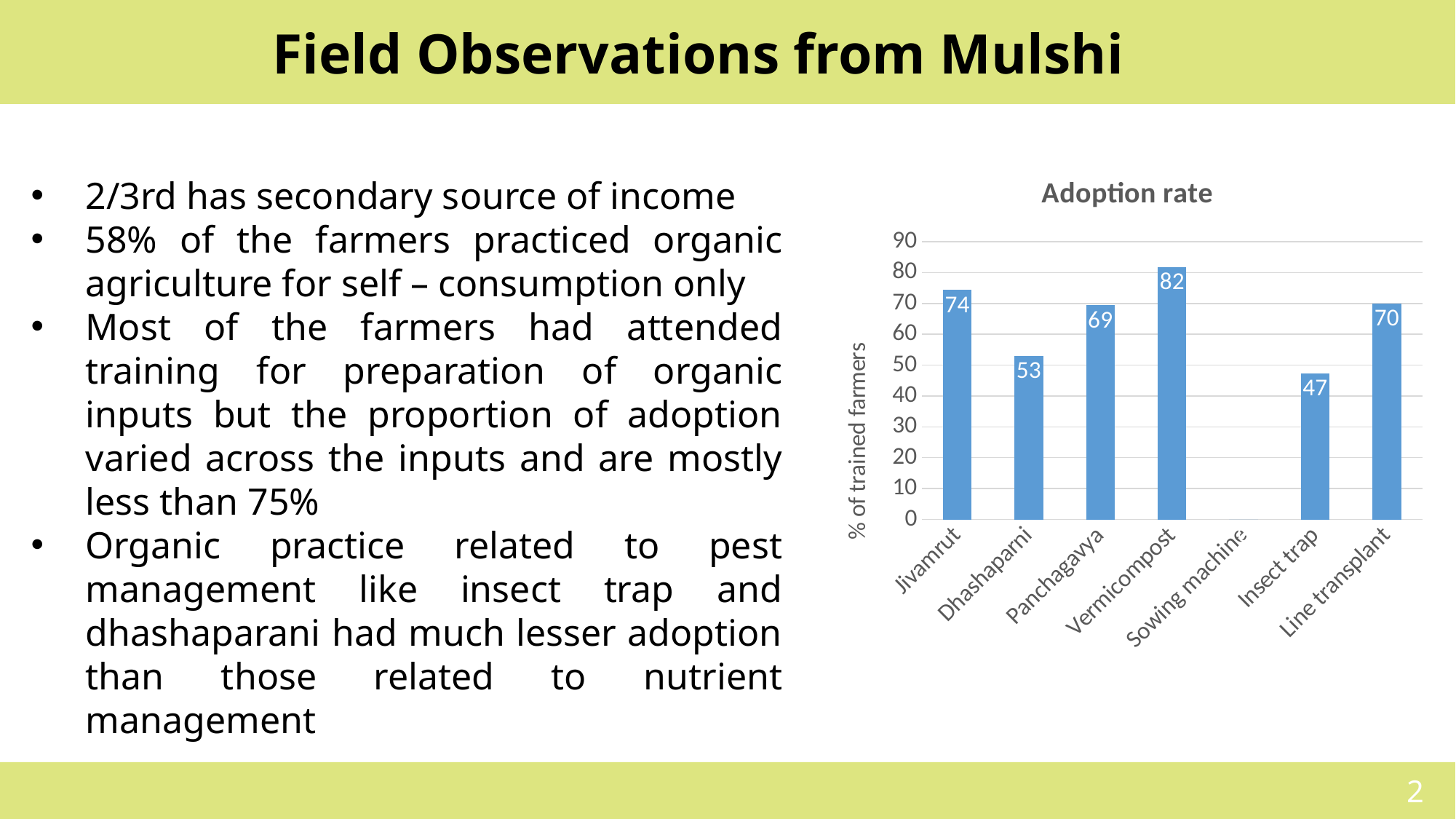
Which category with a plotted bar has the lowest adoption rate? Insect trap How many categories are labelled on the x axis of the chart? 7 Which has a higher adoption rate, Jivamrut or Panchagavya? Jivamrut What is the label of the vertical axis of the chart? % of trained farmers What is the adoption rate for Vermicompost? 82 Which category has the highest adoption rate? Vermicompost What is the adoption rate for Insect trap? 47 What is the adoption rate for Dhashaparni? 53 What is the title of the chart? Adoption rate What kind of chart is shown on the slide? Bar chart What is the adoption rate for Line transplant? 70 What is the difference between the adoption rates of Vermicompost and Insect trap? 35